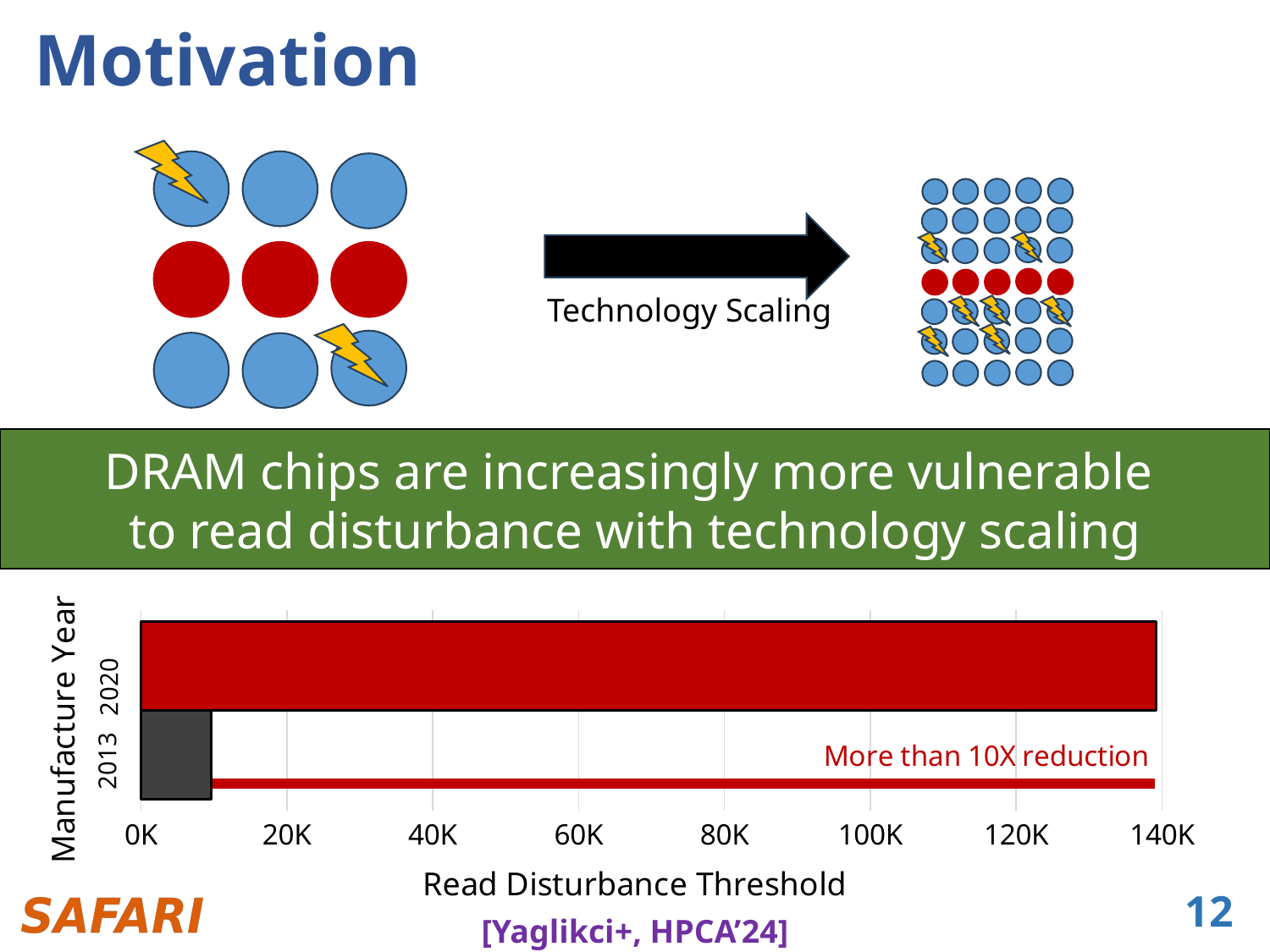
What annotation text is written in red inside the chart? More than 10X reduction Is the value of the bottom (dark gray) bar greater or less than 20K? less What kind of chart is shown at the bottom of the slide? bar chart How many bars are plotted in the chart? 2 Is the value of the top (red) bar greater or less than 100K? greater Is the value of the top (red) bar greater or less than 120K? greater What is the title of the x axis of the chart? Read Disturbance Threshold Which bar has the lowest Read Disturbance Threshold? the bottom dark gray bar Which bar is longer, the top red bar or the bottom dark gray bar? the top red bar